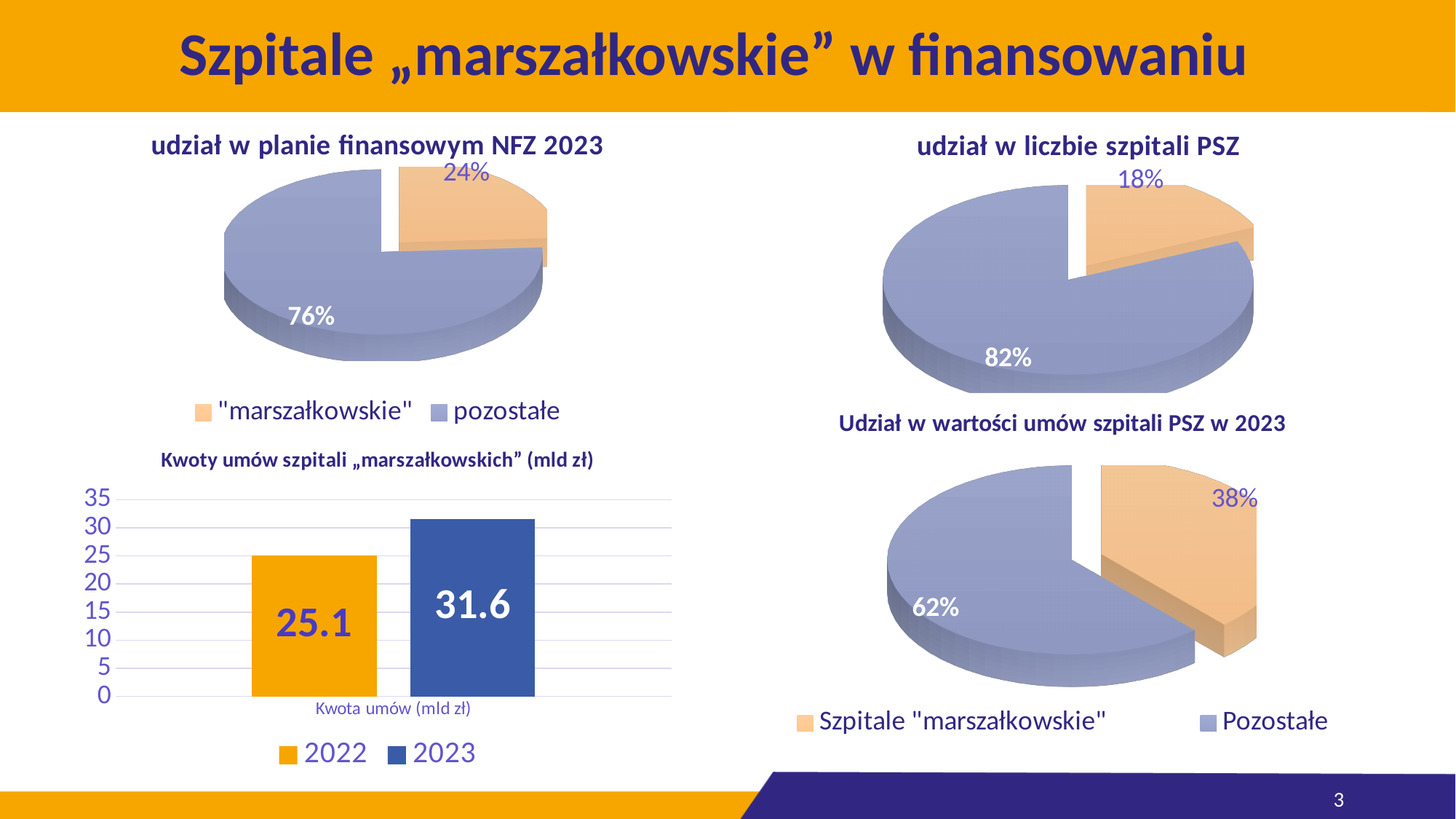
What kind of chart is "Kwoty umów szpitali „marszałkowskich” (mld zł)"? bar chart In the chart "udział w planie finansowym NFZ 2023", what share do the "pozostałe" hospitals have? 76% In the chart "udział w liczbie szpitali PSZ", what share do the "marszałkowskie" hospitals have? 18% In the chart "Kwoty umów szpitali „marszałkowskich” (mld zł)", what is the value for 2022? 25.1 In the chart "Kwoty umów szpitali „marszałkowskich” (mld zł)", what is the difference between the 2023 and 2022 values? 6.5 What kind of chart is "udział w liczbie szpitali PSZ"? pie chart In the chart "udział w planie finansowym NFZ 2023", what share do the "marszałkowskie" hospitals have? 24% In the chart "Kwoty umów szpitali „marszałkowskich” (mld zł)", how many series does the legend list? 2 In the chart "Udział w wartości umów szpitali PSZ w 2023", which slice is larger, "Szpitale marszałkowskie" or "Pozostałe"? Pozostałe In the chart "Kwoty umów szpitali „marszałkowskich” (mld zł)", what is the value for 2023? 31.6